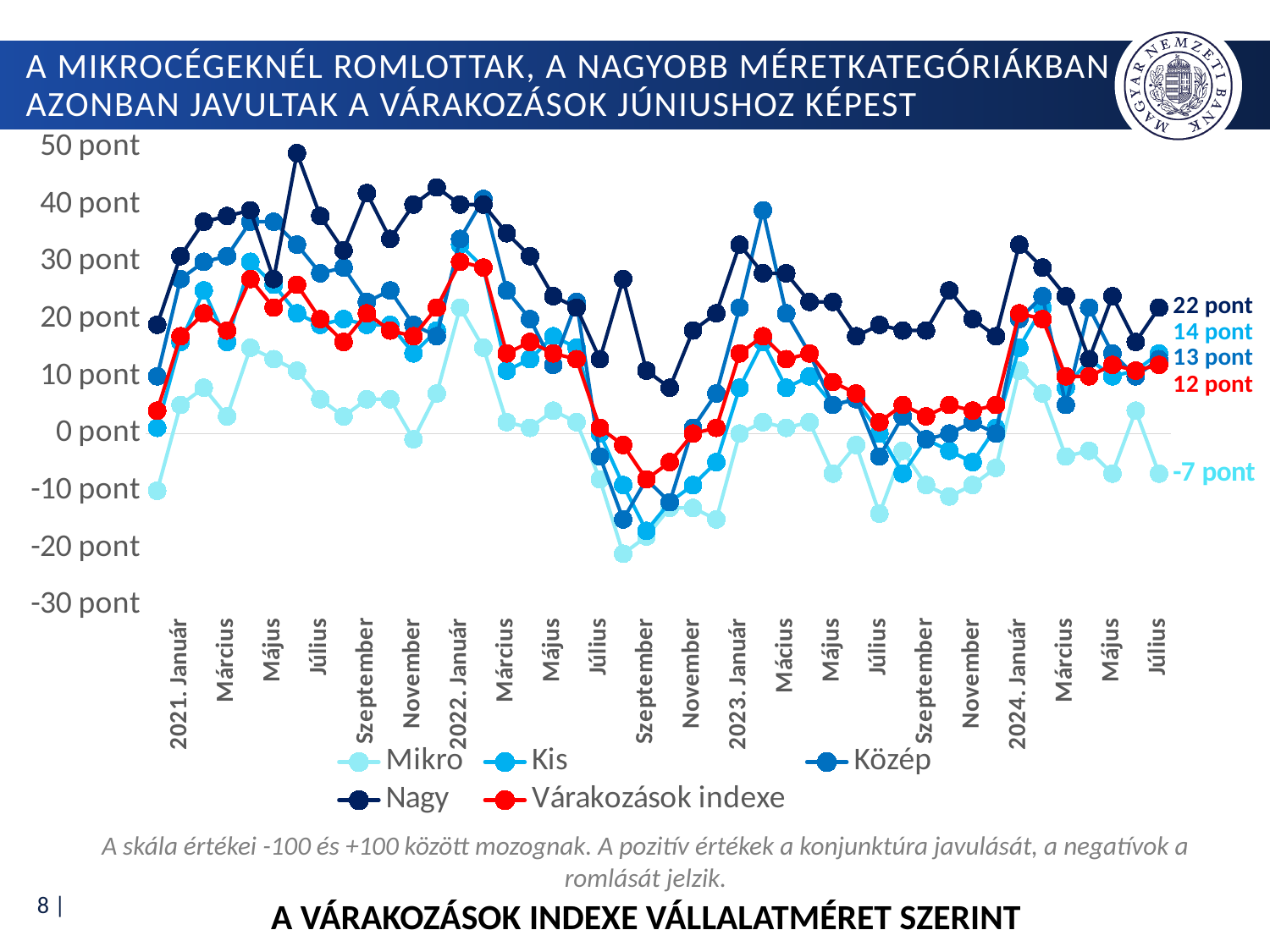
What is the value of the Mikro series at the last point (2024 Július)? -7 pont Which series has the lowest value at the last point (2024 Július)? Mikro How many series does the legend list? 5 What is the value of the Várakozások indexe series at the last point (2024 Július)? 12 pont Is the value of the Mikro series in 2022 Szeptember greater or less than -10 pont? less At the last point (2024 Július), which is larger: the Kis value or the Közép value? Kis What is the value of the Kis series at the last point (2024 Július)? 14 pont What is the value of the Nagy series at the last point (2024 Július)? 22 pont What kind of chart is shown on the slide? line chart Which series has the highest value at the last point (2024 Július)? Nagy What is the difference between the Nagy and Mikro values at the last point (2024 Július)? 29 pont What is the value of the Közép series at the last point (2024 Július)? 13 pont